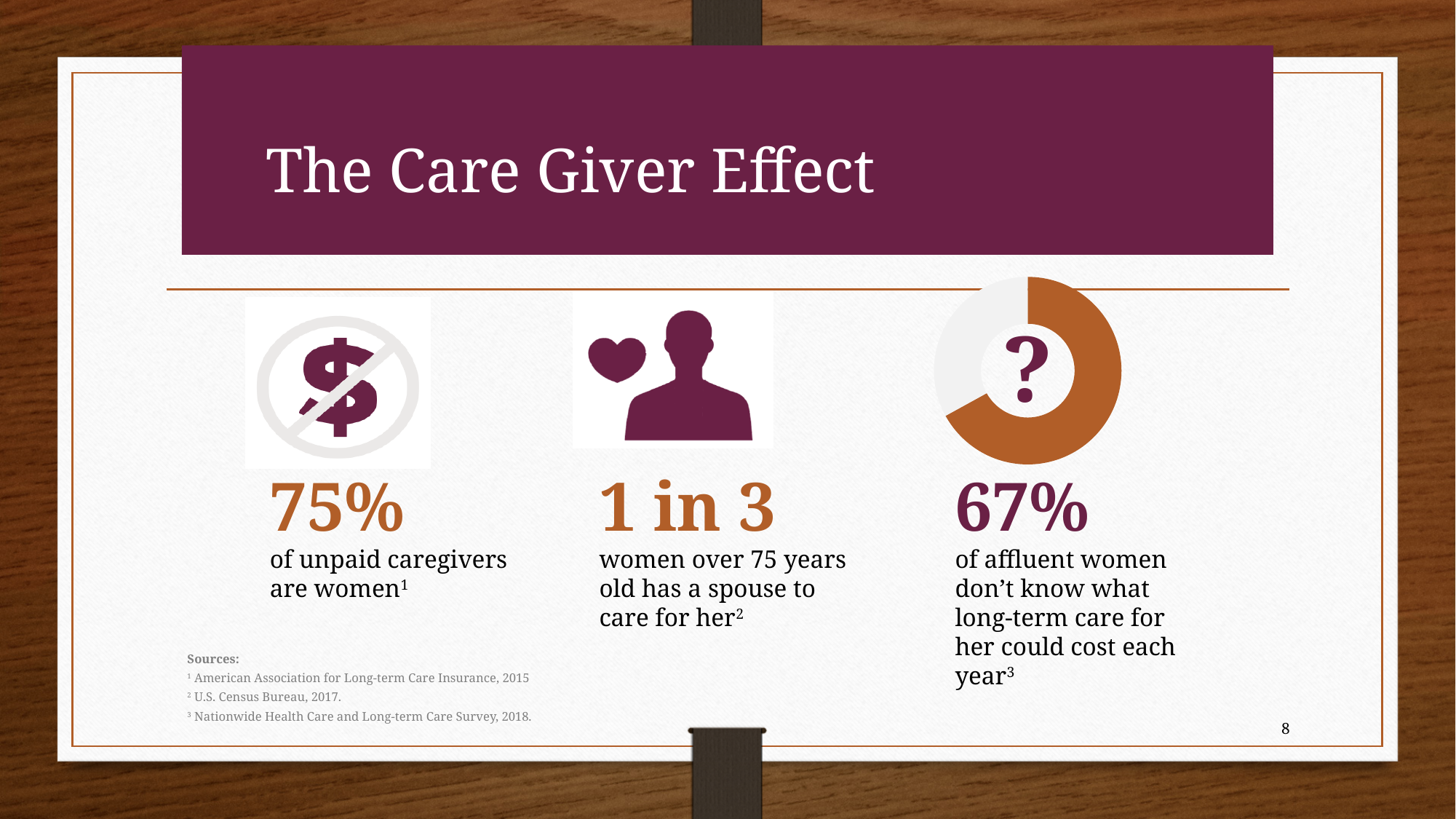
In the donut chart on the right, is the orange portion greater or less than 50%? greater What symbol is displayed in the centre of the donut chart? A question mark What share of the donut chart on the right is filled in orange? 67% What kind of chart is shown on the right side of the slide, around the question mark? Donut (pie) chart What does the 67% shown with the donut chart represent? Affluent women who don't know what long-term care for her could cost each year How many distinct portions does the donut chart on the right have? 2 In the donut chart on the right, which portion is larger, the orange portion or the grey portion? The orange portion